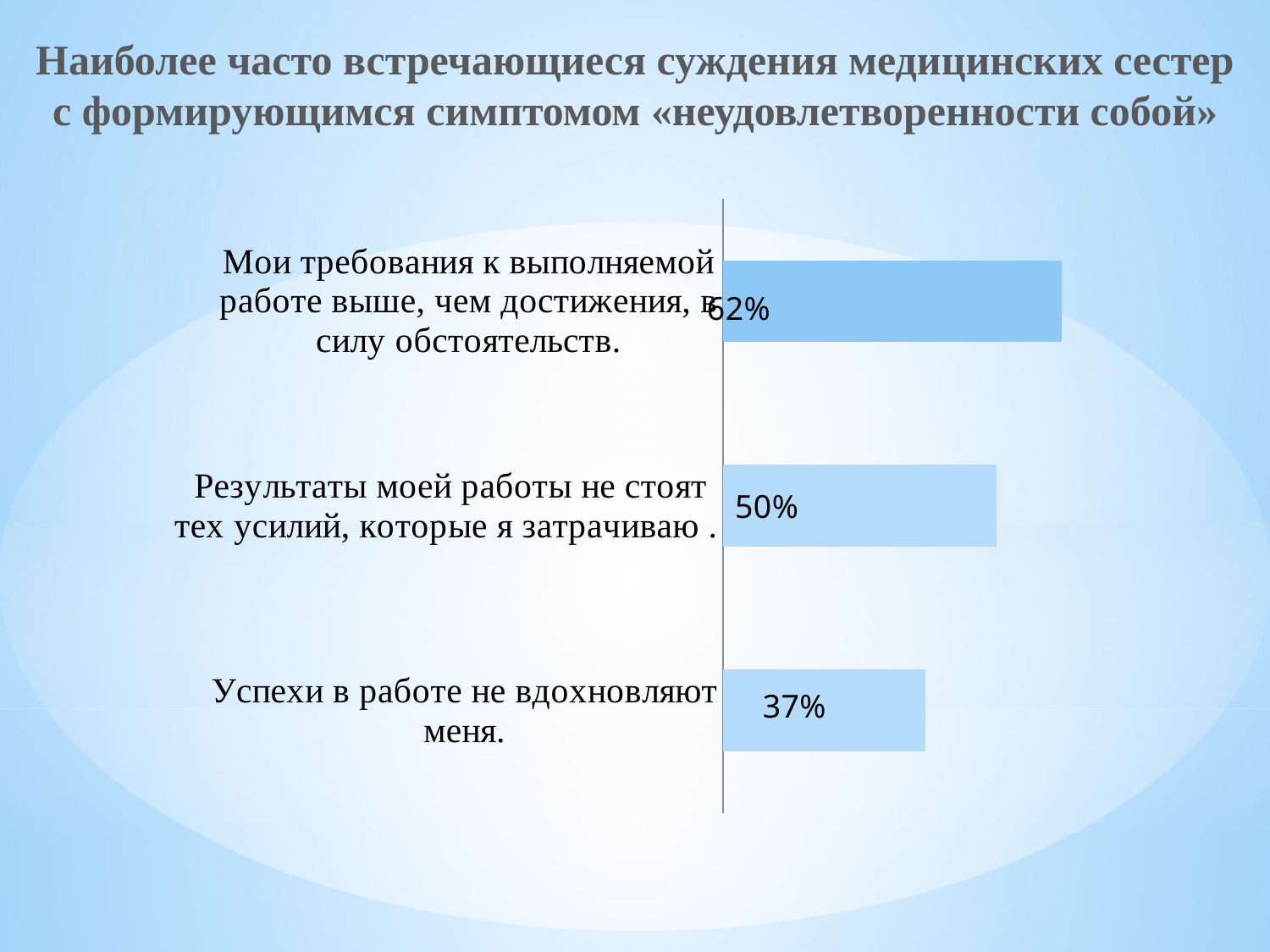
What is the value for «Успехи в работе не вдохновляют меня»? 37% What kind of chart is shown on the slide? bar chart Which is larger: the value for «Результаты моей работы не стоят тех усилий, которые я затрачиваю» or the value for «Успехи в работе не вдохновляют меня»? Результаты моей работы не стоят тех усилий, которые я затрачиваю. How many categories (statements) are plotted in the chart? 3 What is the value for «Результаты моей работы не стоят тех усилий, которые я затрачиваю»? 50% What is the difference between the values for «Мои требования к выполняемой работе выше, чем достижения, в силу обстоятельств» and «Результаты моей работы не стоят тех усилий, которые я затрачиваю»? 12% What colour are the bars in the chart? light blue What is the value for «Мои требования к выполняемой работе выше, чем достижения, в силу обстоятельств»? 62% Which statement has the lowest value? Успехи в работе не вдохновляют меня. What is the difference between the values for «Результаты моей работы не стоят тех усилий, которые я затрачиваю» and «Успехи в работе не вдохновляют меня»? 13% Do the bar values increase or decrease from the top bar to the bottom bar? decrease Which statement has the highest value? Мои требования к выполняемой работе выше, чем достижения, в силу обстоятельств.